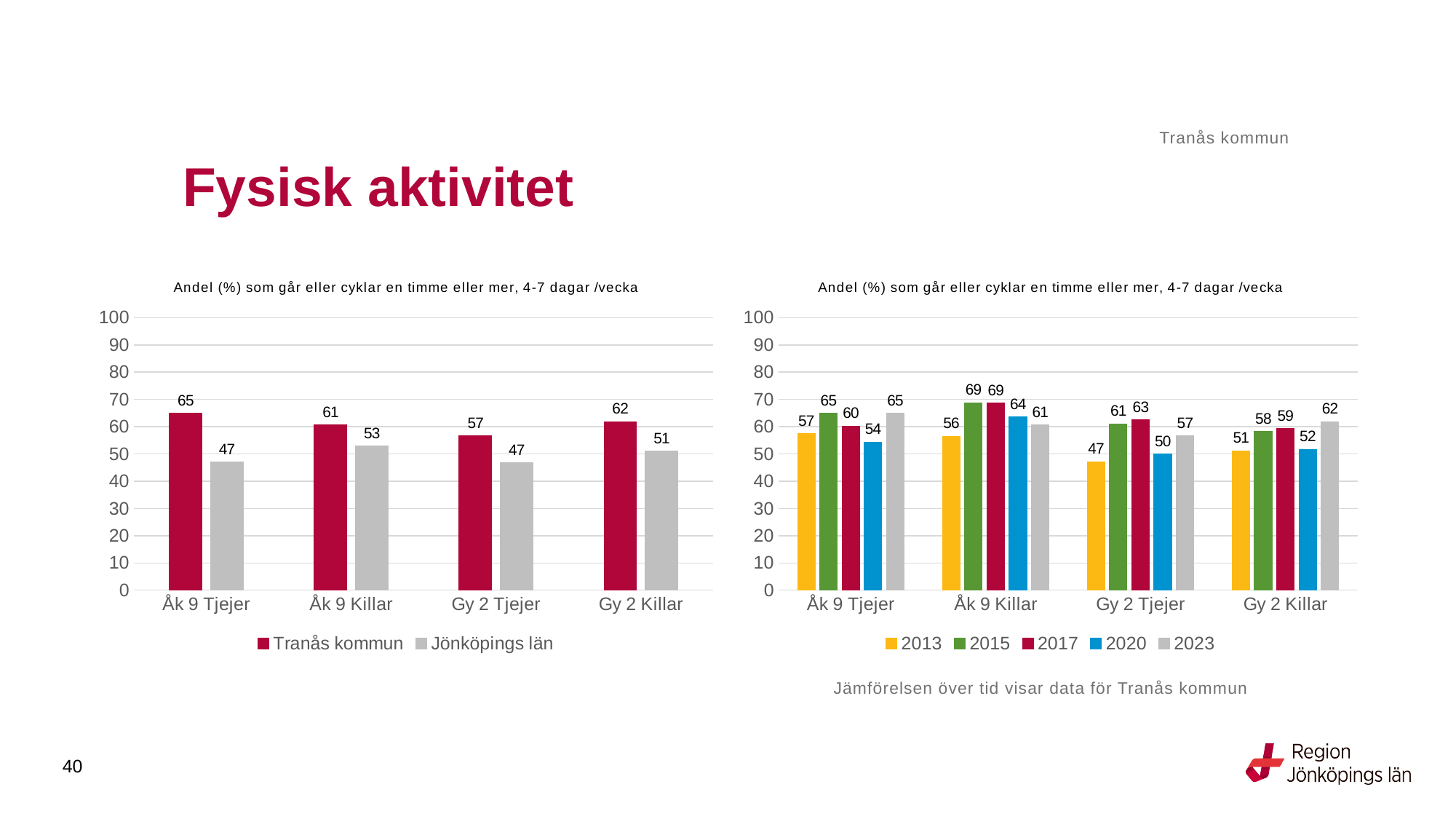
In the left chart, what is the difference between Tranås kommun and Jönköpings län for Åk 9 Tjejer? 18 What kind of chart is the left chart? Bar chart In the right chart, how many series does the legend list? 5 In the left chart, what is the value for Tranås kommun for Åk 9 Tjejer? 65 In the left chart, what is the value for Jönköpings län for Åk 9 Killar? 53 In the right chart, what is the difference between the 2023 and 2013 values for Gy 2 Killar? 11 In the left chart, how many series does the legend list? 2 In the right chart, what is the value for 2020 for Gy 2 Killar? 52 In the right chart, which year has the highest value for Gy 2 Killar? 2023 In the right chart, is the value for 2015 for Åk 9 Killar larger or smaller than the value for 2020 for Åk 9 Killar? Larger In the right chart, what is the value for 2013 for Gy 2 Tjejer? 47 In the left chart, which category has the lowest value for Tranås kommun? Gy 2 Tjejer